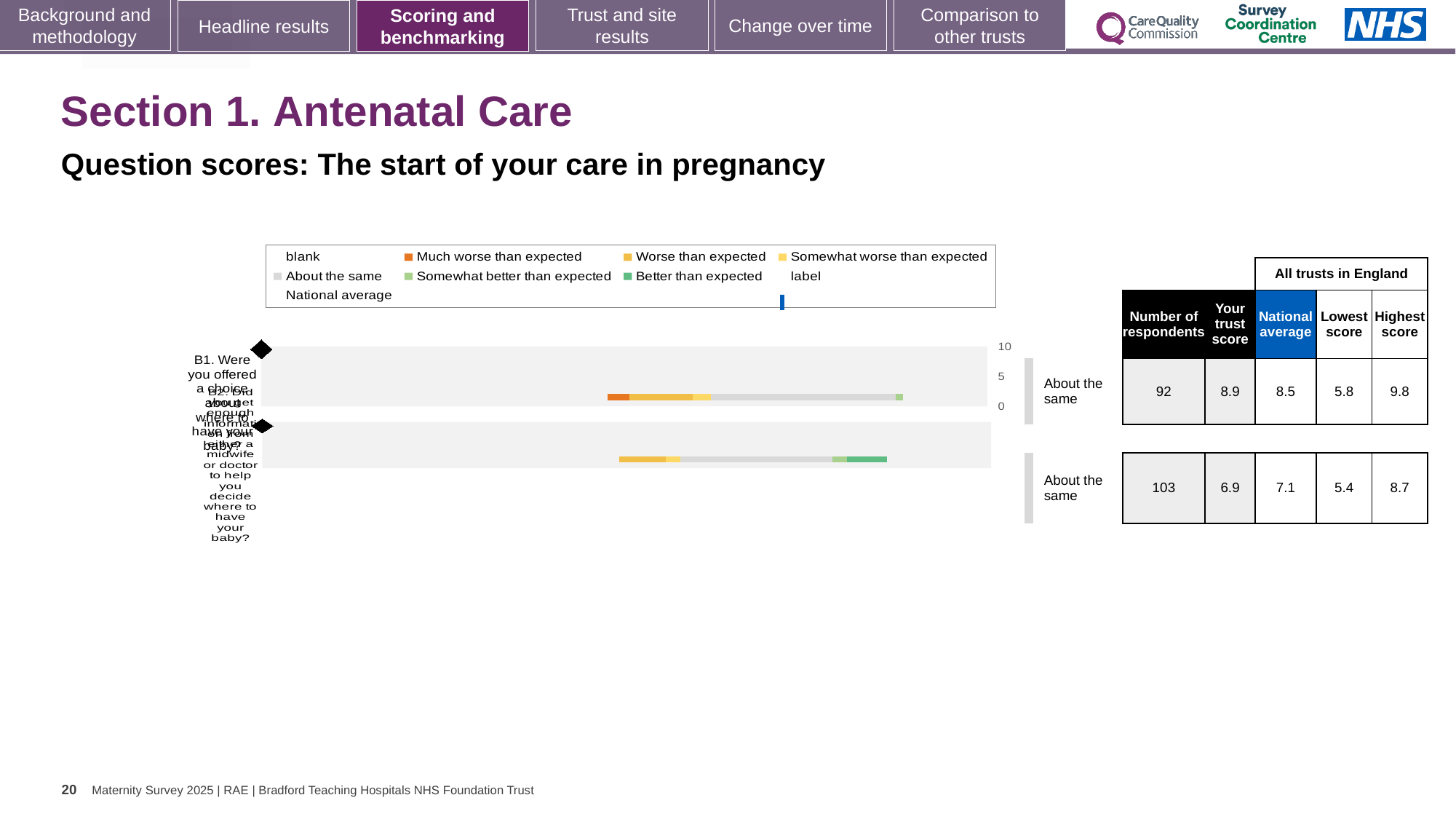
For question B1, is the trust score or the national average larger? trust score What is the trust score for question B1 (Were you offered a choice about where to have your baby?)? 8.9 Which question has the higher trust score, B1 or B2? B1 What kind of chart is shown on the slide? bar chart What colour represents 'Much worse than expected' in the legend? orange What is the difference between the trust score and the national average for question B1? 0.4 What is the difference between the highest score and the lowest score for question B2? 3.3 What is the national average for question B2 (Did you get enough information from either a midwife or doctor to help you decide where to have your baby?)? 7.1 How many questions (categories) are plotted in the chart? 2 What benchmark category is shown for question B2? About the same How many respondents answered question B2? 103 What is the highest score across all trusts in England for question B1? 9.8